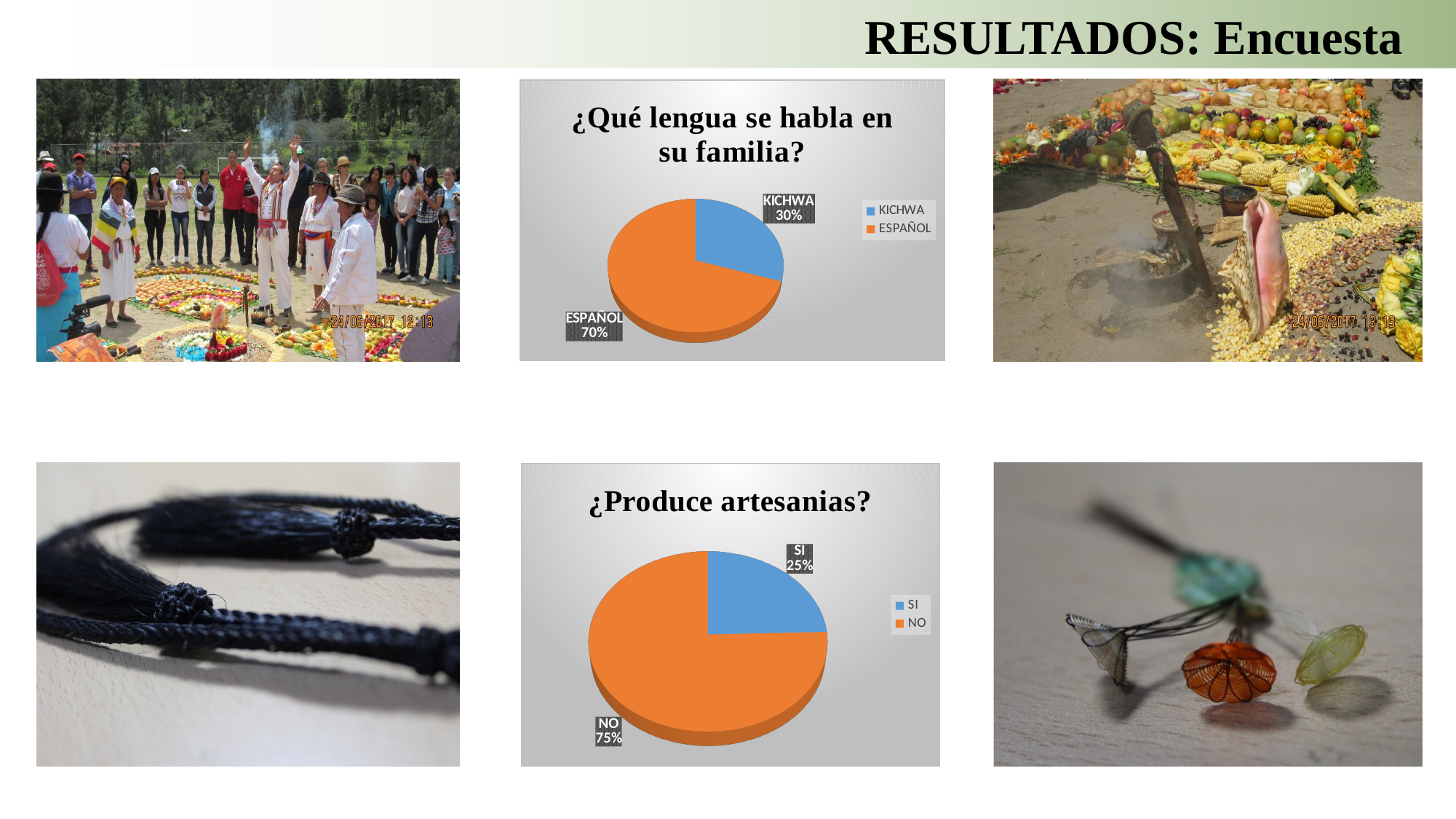
In the chart titled '¿Qué lengua se habla en su familia?', what is the value for KICHWA? 30% In the chart titled '¿Qué lengua se habla en su familia?', which category has the largest slice? ESPAÑOL What kind of chart is the one titled '¿Qué lengua se habla en su familia?'? Pie chart In the chart titled '¿Qué lengua se habla en su familia?', what share of the pie is ESPAÑOL? 70% In the chart titled '¿Produce artesanias?', which category has the smallest slice? SI In the chart titled '¿Produce artesanias?', is the value for NO larger or smaller than the value for SI? Larger In the chart titled '¿Qué lengua se habla en su familia?', what is the difference between the ESPAÑOL and KICHWA shares? 40% In the chart titled '¿Produce artesanias?', what share of the pie is NO? 75% In the chart titled '¿Produce artesanias?', how many entries does the legend list? 2 In the chart titled '¿Produce artesanias?', what is the value for SI? 25% In the chart titled '¿Produce artesanias?', what colour is the NO slice? Orange In the chart titled '¿Qué lengua se habla en su familia?', how many categories are shown? 2